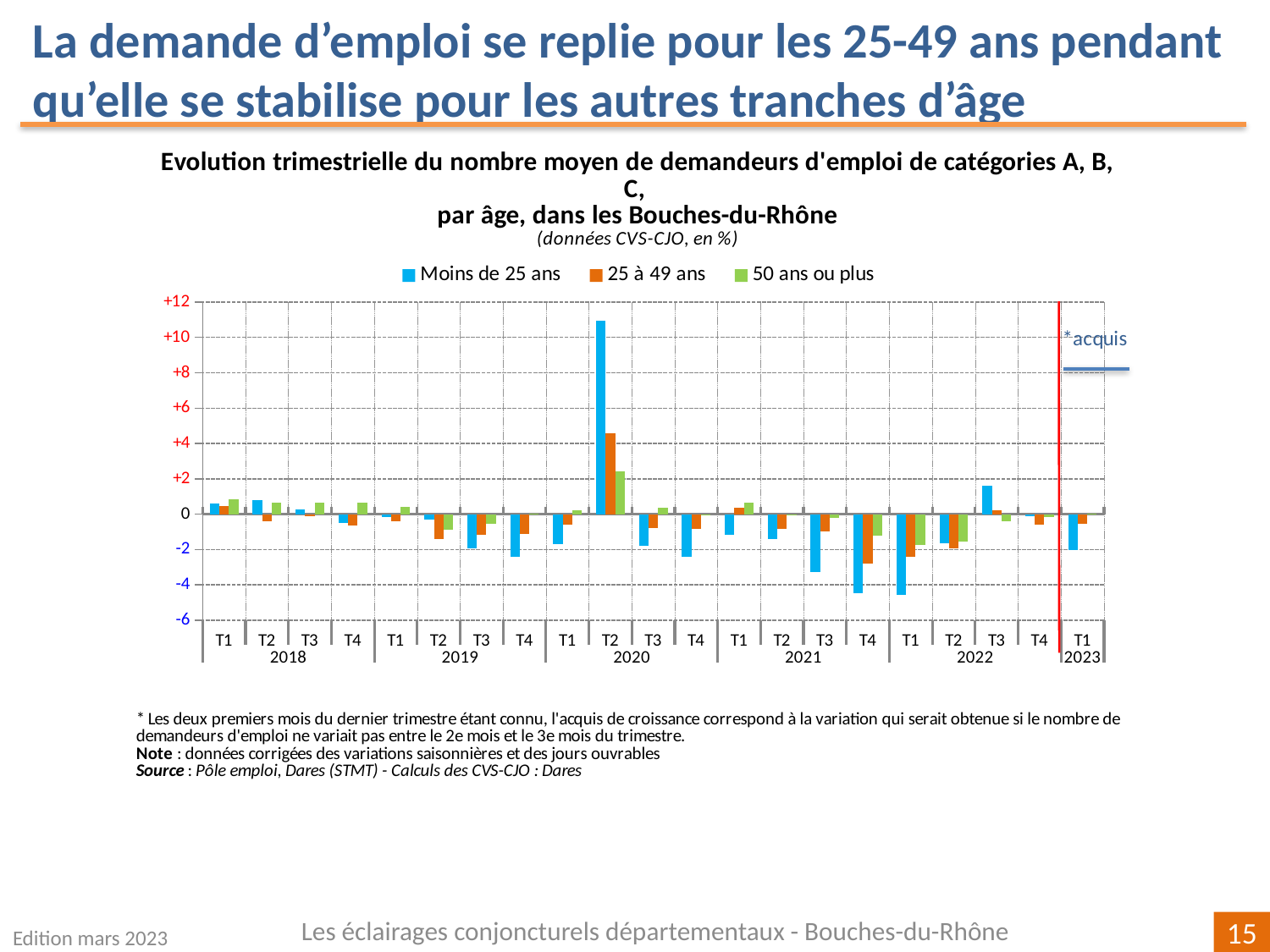
Is the value for '25 à 49 ans' in T2 2020 greater or less than +2? greater How many quarters are shown along the x axis? 21 Is the value for 'Moins de 25 ans' in T4 2021 greater or less than -2? less Which colour represents the '25 à 49 ans' series in the legend? orange In which quarter does the 'Moins de 25 ans' series reach its highest value? T2 2020 In T2 2020, which series has the larger value: 'Moins de 25 ans' or '25 à 49 ans'? Moins de 25 ans Is the value for 'Moins de 25 ans' in T1 2022 greater or less than -2? less How many series does the legend list? 3 What kind of chart is shown on the slide? bar chart In T4 2021, which series has the larger value: 'Moins de 25 ans' or '50 ans ou plus'? 50 ans ou plus